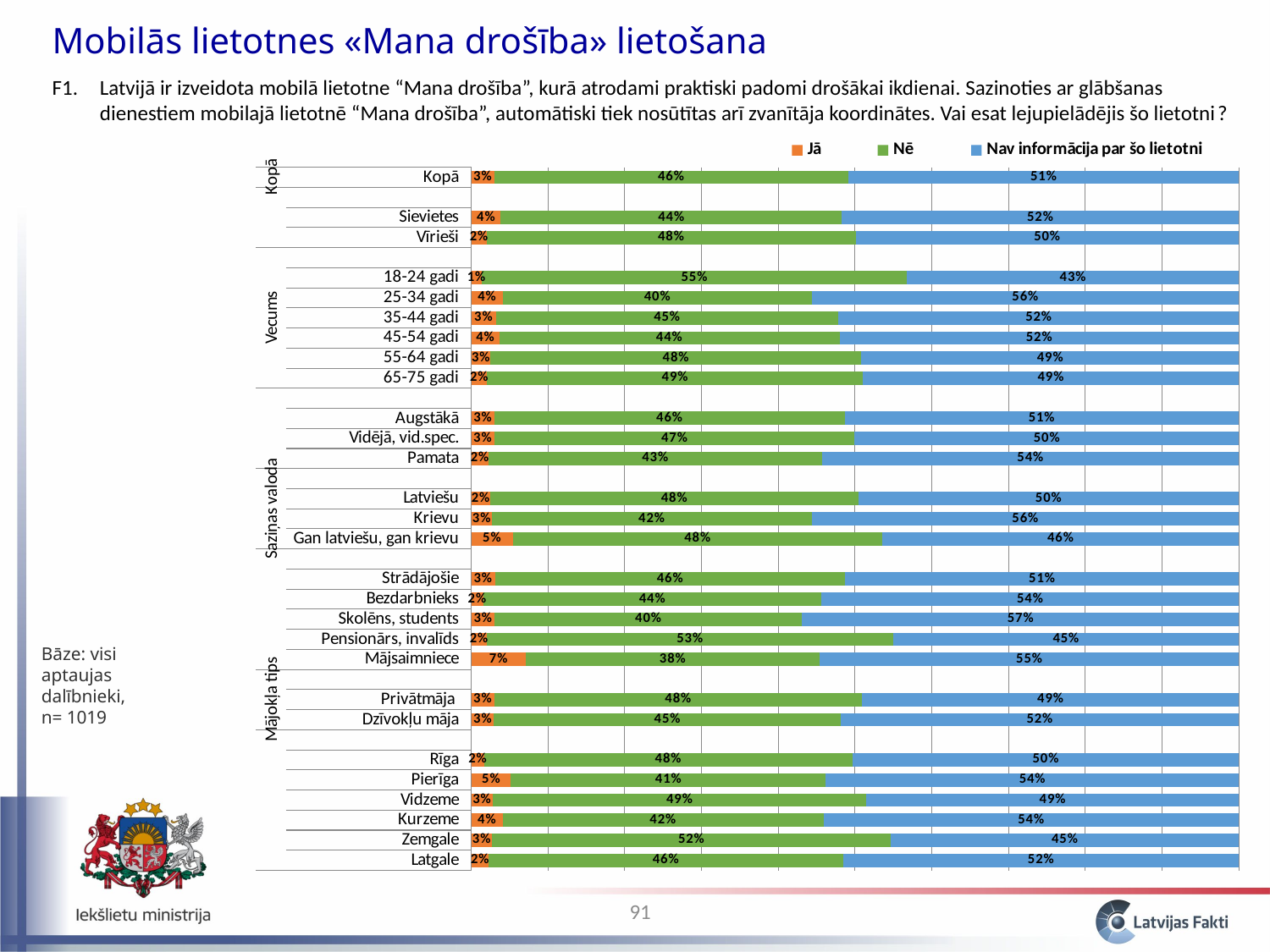
Which category has the lowest 'Jā' value? 18-24 gadi What is the base (n) of respondents stated on the slide? n= 1019 What is the difference between the 'Nē' values for Sievietes and Vīrieši? 4 percentage points Which has a larger 'Nav informācija par šo lietotni' value, Krievu or Latviešu? Krievu What is the total of the stacked bar for Mājsaimniece? 100% What is the 'Nav informācija par šo lietotni' value for Skolēns, students? 57% What is the 'Nē' value for the 18-24 gadi group? 55% How many series does the legend list? 3 Which category has the highest 'Jā' value? Mājsaimniece What is the 'Jā' value for Pierīga? 5% What type of chart is shown on the slide? Stacked bar chart What percentage of respondents in the 'Kopā' row answered 'Jā'? 3%